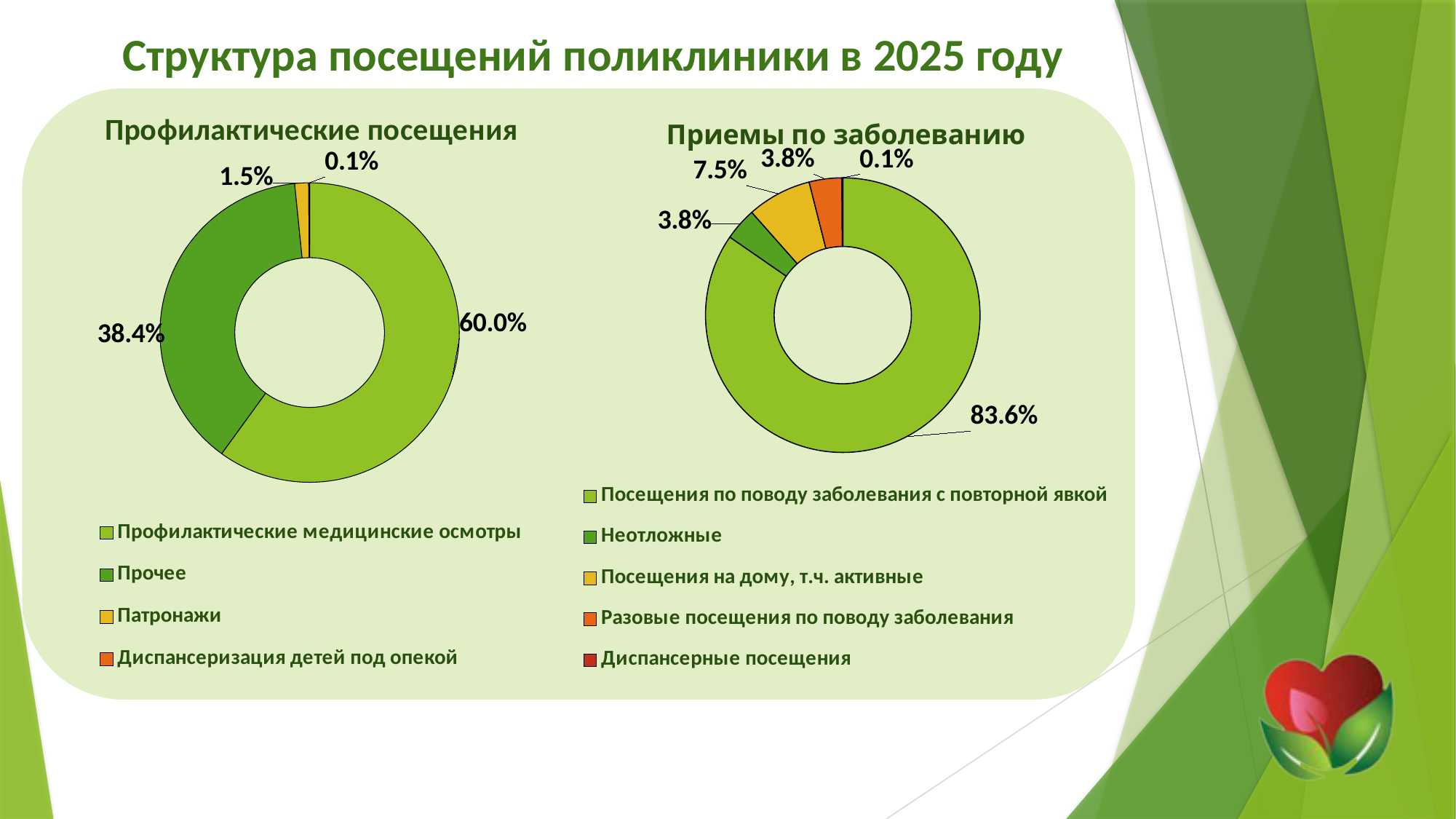
In the "Приемы по заболеванию" chart, which is larger: "Посещения на дому, т.ч. активные" or "Неотложные"? Посещения на дому, т.ч. активные How many categories does the legend of the "Приемы по заболеванию" chart list? 5 In the "Профилактические посещения" chart, what is the share of "Патронажи"? 1.5% In the "Профилактические посещения" chart, which category has the smallest share? Диспансеризация детей под опекой What type of chart is used for "Профилактические посещения"? Doughnut (pie) chart In the "Профилактические посещения" chart, what is the difference between the shares of "Профилактические медицинские осмотры" and "Прочее"? 21.6% What is the title of the slide? Структура посещений поликлиники в 2025 году In the "Приемы по заболеванию" chart, what is the share of "Диспансерные посещения"? 0.1% In the "Профилактические посещения" chart, what is the share of "Прочее"? 38.4% In the "Профилактические посещения" chart, what is the share of "Профилактические медицинские осмотры"? 60.0% In the "Приемы по заболеванию" chart, what is the share of "Посещения по поводу заболевания с повторной явкой"? 83.6% In the "Приемы по заболеванию" chart, what is the share of "Посещения на дому, т.ч. активные"? 7.5%